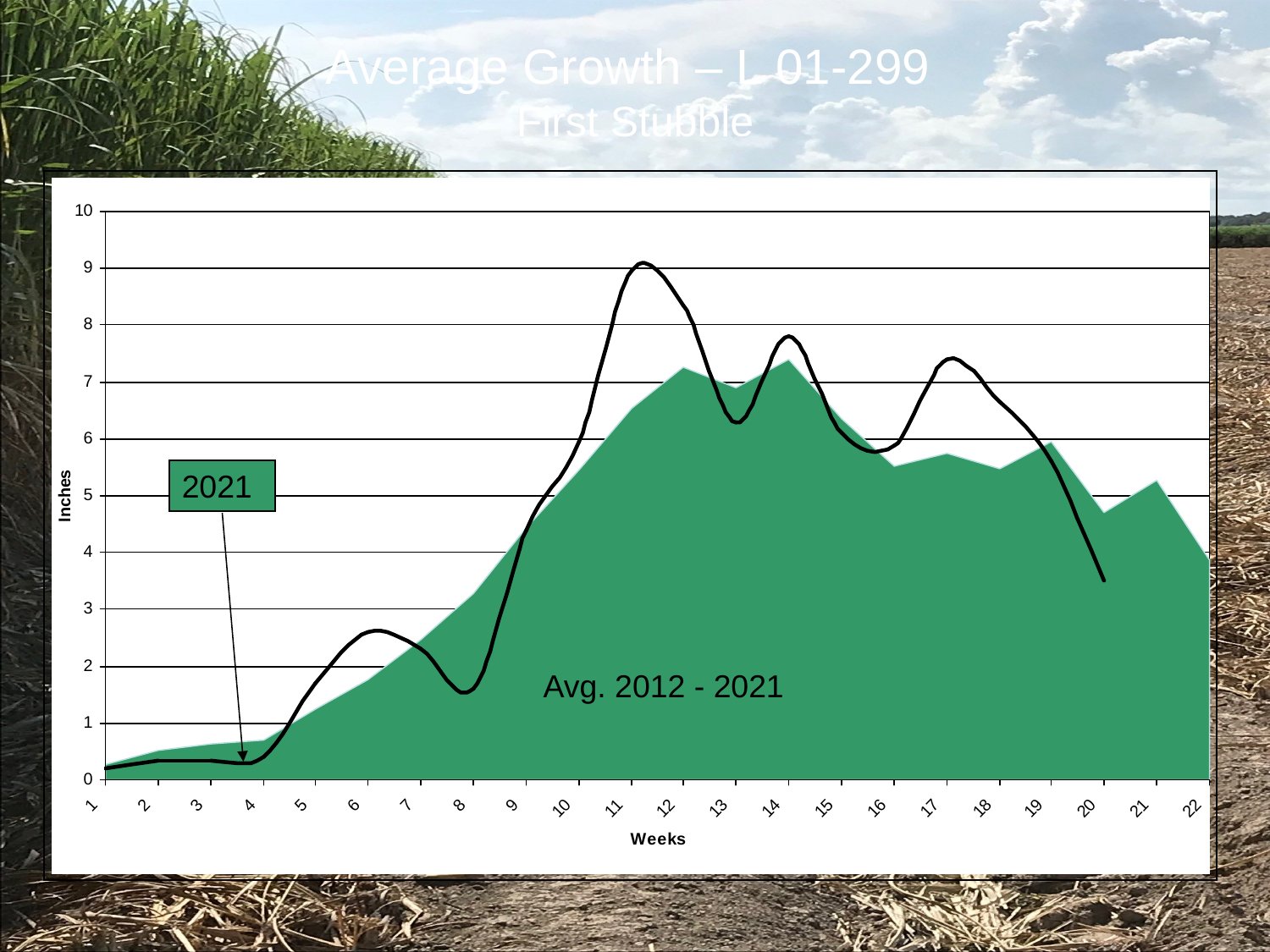
What is the label of the y axis? Inches What kind of chart is shown on the slide? Area and line chart Does the 2021 line rise or fall from week 1 to week 11? rise Is the 2021 value at week 20 greater or less than 4? less At week 8, which series has the larger value, 2021 or Avg. 2012 - 2021? Avg. 2012 - 2021 Is the 2021 value at week 14 greater or less than 7? greater Is the 2021 value at week 8 greater or less than 2? less How many series are plotted on the chart? 2 What is the label of the x axis? Weeks How many weeks are shown on the x axis of the chart? 22 At week 11, which series has the larger value, 2021 or Avg. 2012 - 2021? 2021